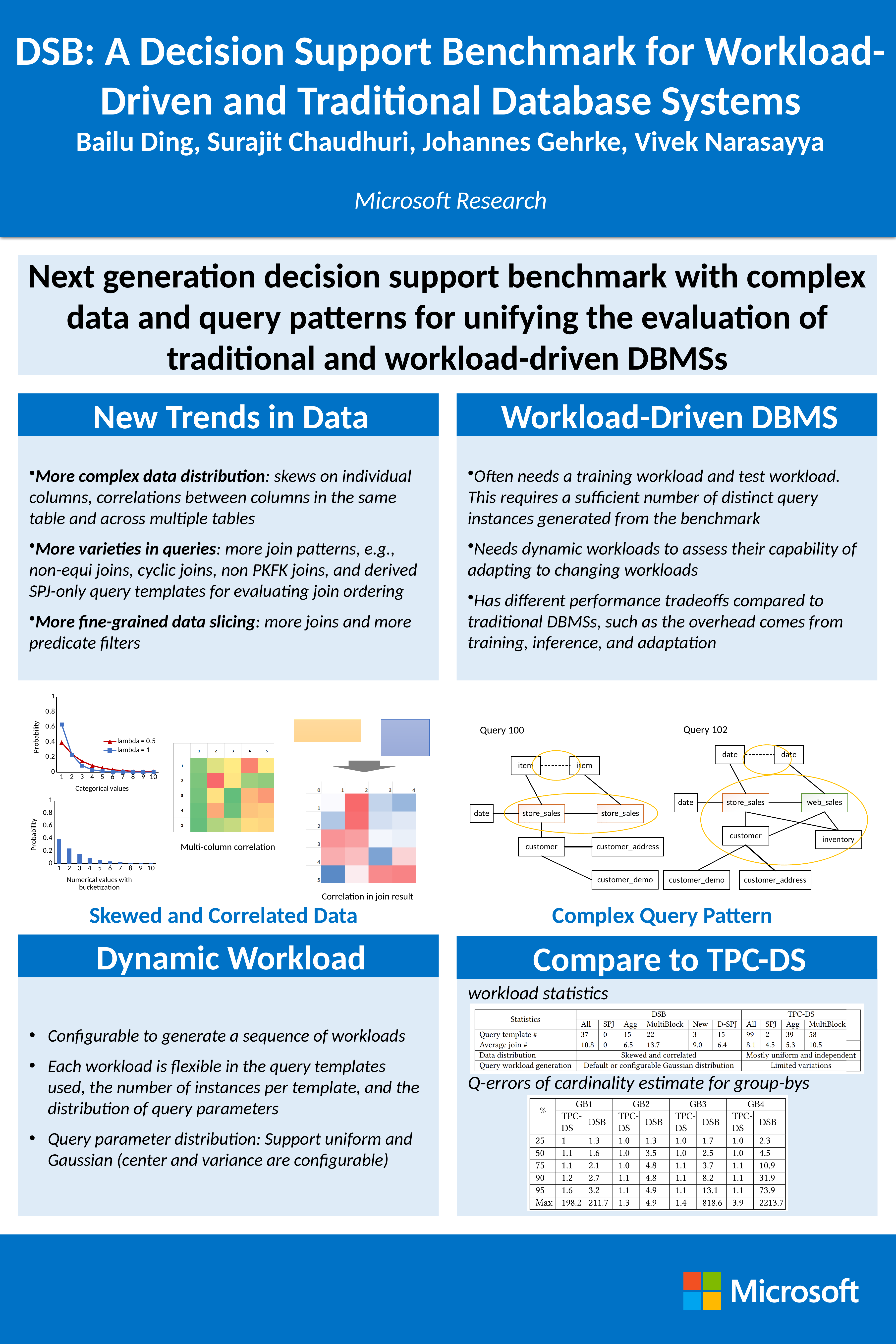
In the chart with x-axis 'Categorical values', which series has the larger value at x = 1, lambda = 0.5 or lambda = 1? lambda = 1 In the chart with x-axis 'Numerical values with bucketization', is the bar at x = 1 greater or less than 0.6? less In the chart with x-axis 'Numerical values with bucketization', which x value has the highest bar? 1 What kind of chart is the one with x-axis 'Categorical values'? line chart In the chart with x-axis 'Categorical values' under 'New Trends in Data', how many series does the legend list? 2 In the chart with x-axis 'Categorical values', is the value of lambda = 0.5 at x = 1 greater or less than 0.6? less In the chart with x-axis 'Numerical values with bucketization', how many bars are plotted? 10 In the chart with x-axis 'Categorical values', is the value of lambda = 1 at x = 1 greater or less than 0.4? greater In the chart with x-axis 'Categorical values', do the values rise or fall as x increases from 1 to 10? fall In the chart with x-axis 'Categorical values', what are the two legend entries? lambda = 0.5 and lambda = 1 What kind of chart is the one with x-axis 'Numerical values with bucketization'? bar chart In the chart with x-axis 'Numerical values with bucketization', what is the label of the y-axis? Probability